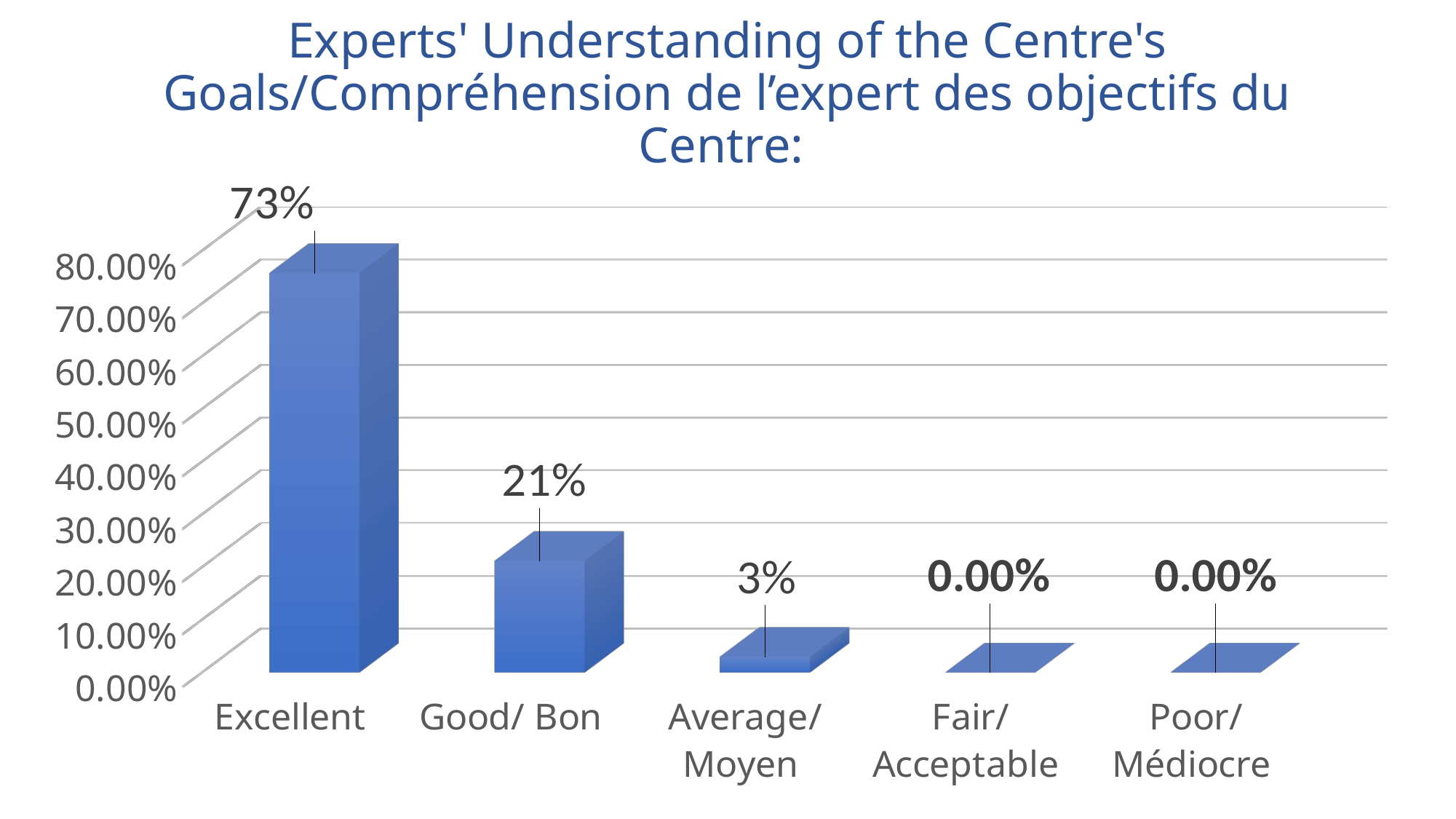
How many categories are shown on the x axis? 5 Do the values rise or fall from Excellent to Poor/ Médiocre along the x axis? fall What is the value for Average/ Moyen? 3% What is the highest tick label shown on the vertical axis? 80.00% Is the value for Excellent greater or less than 70.00%? greater Which category has the highest value? Excellent What is the value for Fair/ Acceptable? 0.00% What is the difference between the values for Excellent and Good/ Bon? 52% What is the value for Good/ Bon? 21% What is the value for Excellent? 73% What kind of chart is this? bar chart Which is larger, the value for Good/ Bon or the value for Average/ Moyen? Good/ Bon